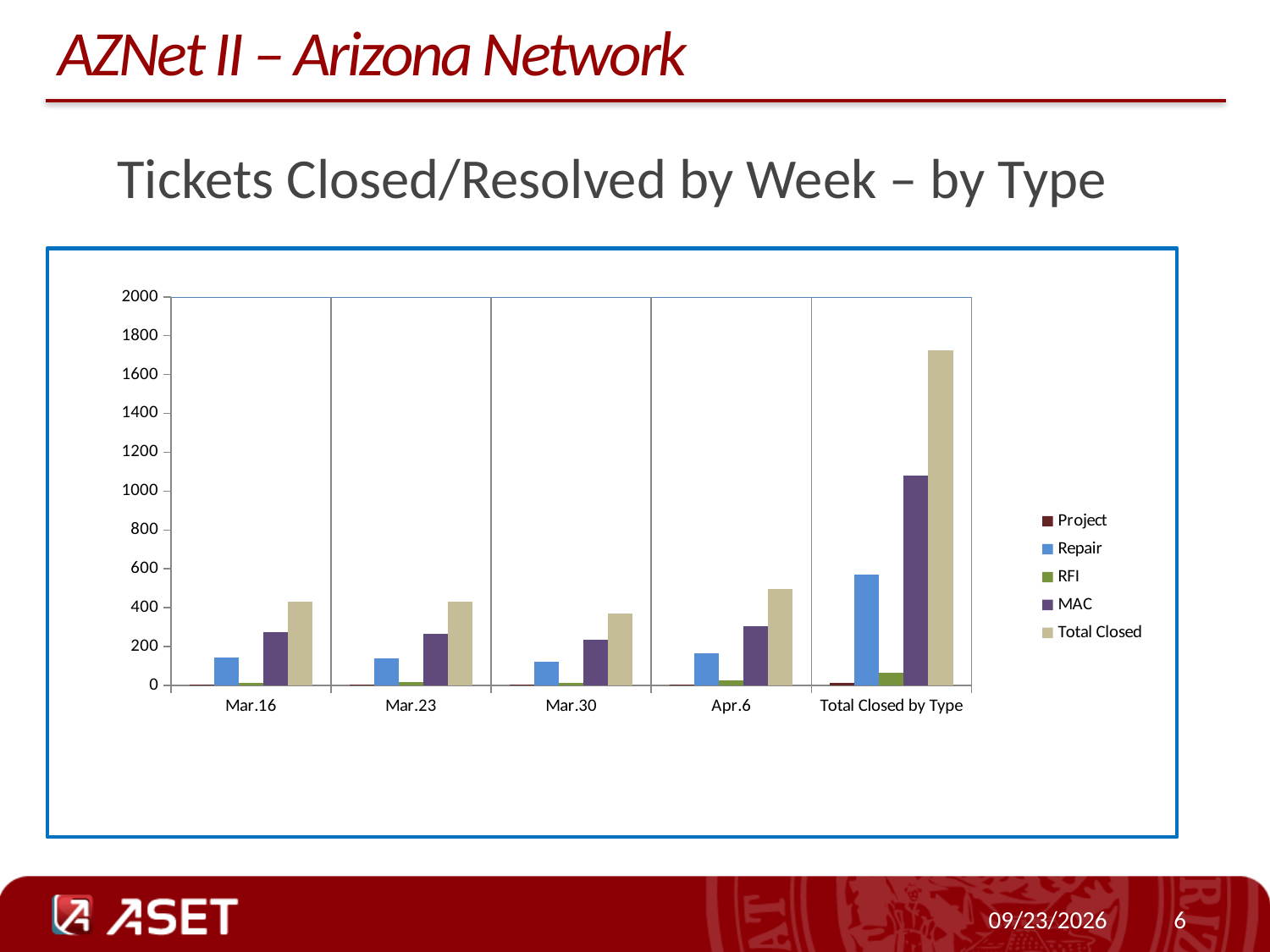
Among the four weekly categories (Mar.16, Mar.23, Mar.30, Apr.6), which has the highest Total Closed value? Apr.6 Is the MAC value for Mar.16 greater or less than 200? greater In the Total Closed by Type category, which series has the smallest bar? Project Among the four weekly categories (Mar.16, Mar.23, Mar.30, Apr.6), which has the lowest Total Closed value? Mar.30 How many series does the legend list? 5 Is the Total Closed value for Mar.30 greater or less than 400? less How many categories are shown along the x axis? 5 What kind of chart is shown on the slide? bar chart Is the MAC value for Total Closed by Type greater or less than 1000? greater For Mar.16, which is larger, the MAC value or the Repair value? MAC